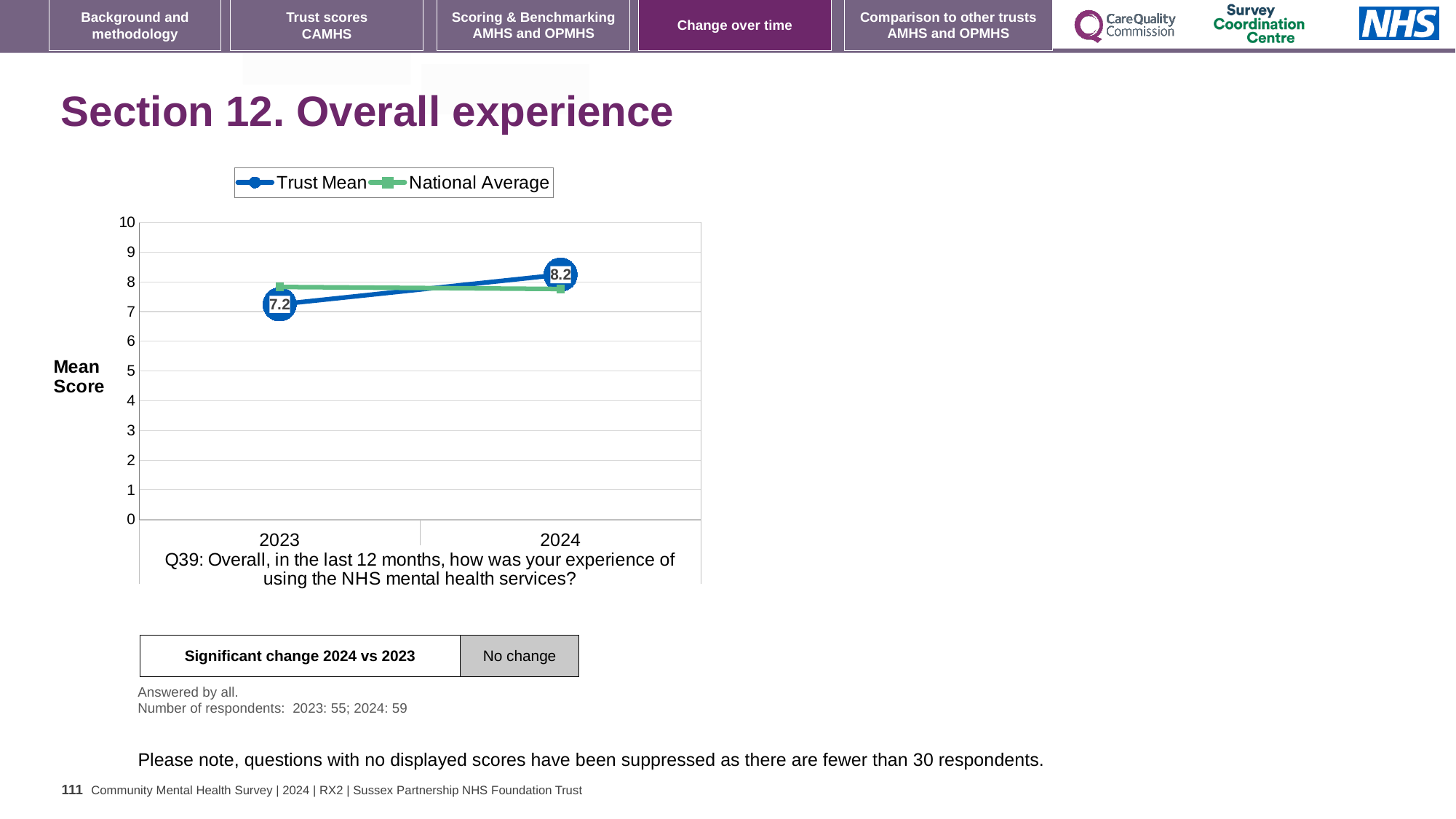
How many years are shown on the x axis? 2 In which year is the Trust Mean highest? 2024 What is the Trust Mean value for 2024? 8.2 Is the National Average value for 2023 greater or less than 7? greater What kind of chart is shown on the slide? line chart Does the Trust Mean rise or fall from 2023 to 2024? rise How many series does the legend list? 2 In 2024, which is higher: the Trust Mean or the National Average? Trust Mean What is the difference between the Trust Mean in 2024 and in 2023? 1.0 In 2023, which is higher: the Trust Mean or the National Average? National Average In which year is the Trust Mean lowest? 2023 What is the Trust Mean value for 2023? 7.2